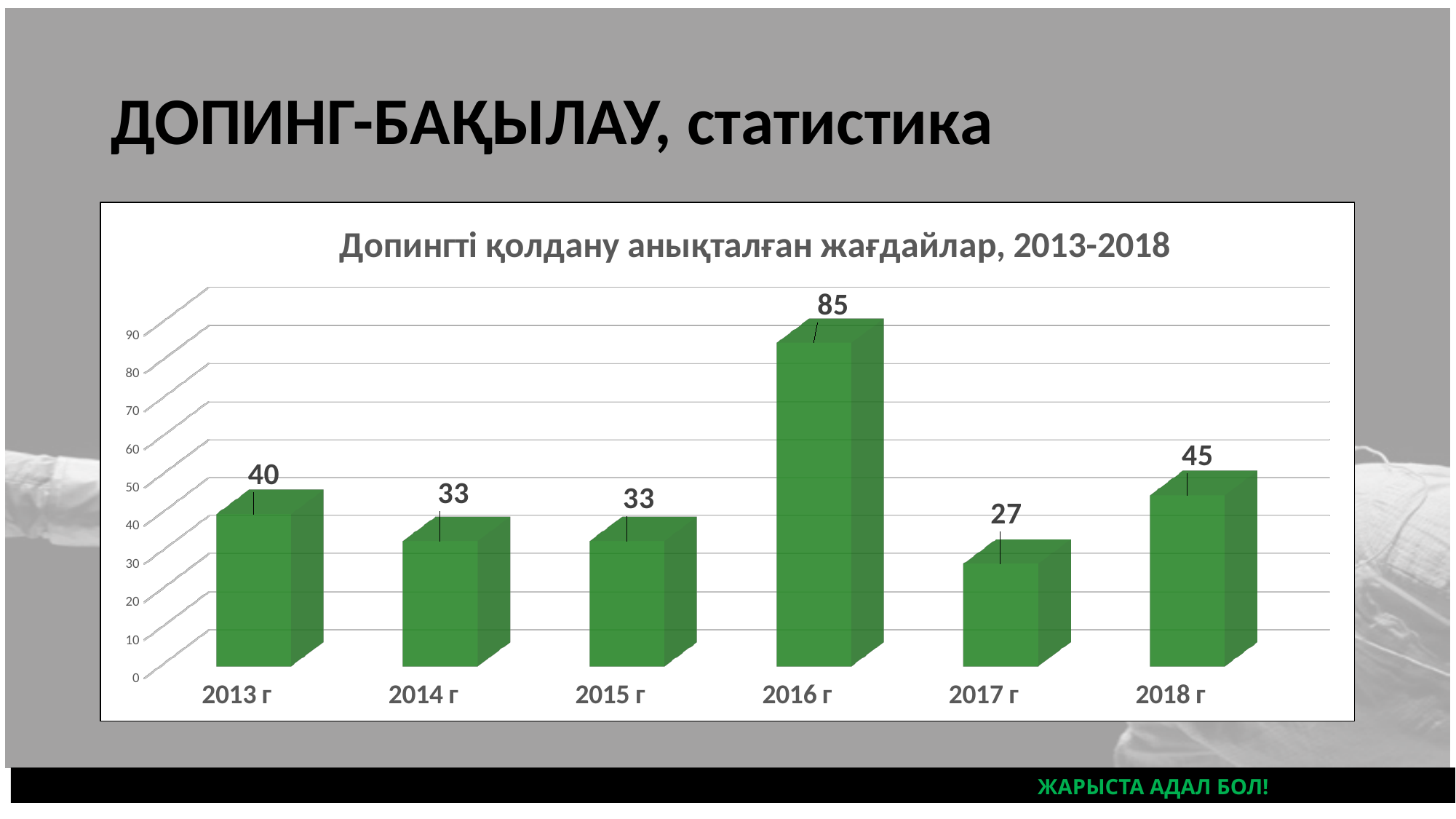
How many years are shown on the x axis? 6 What kind of chart is this? bar chart What is the difference between the values for 2016 г and 2017 г? 58 Which year has the highest value? 2016 г Which year has the lowest value? 2017 г Do the values rise or fall from 2016 г to 2017 г? fall What is the value for 2018 г? 45 What is the value for 2013 г? 40 Which is larger, the value for 2013 г or the value for 2014 г? 2013 г What is the value for 2016 г? 85 What is the difference between the values for 2018 г and 2013 г? 5 What is the title of the chart? Допингті қолдану анықталған жағдайлар, 2013-2018